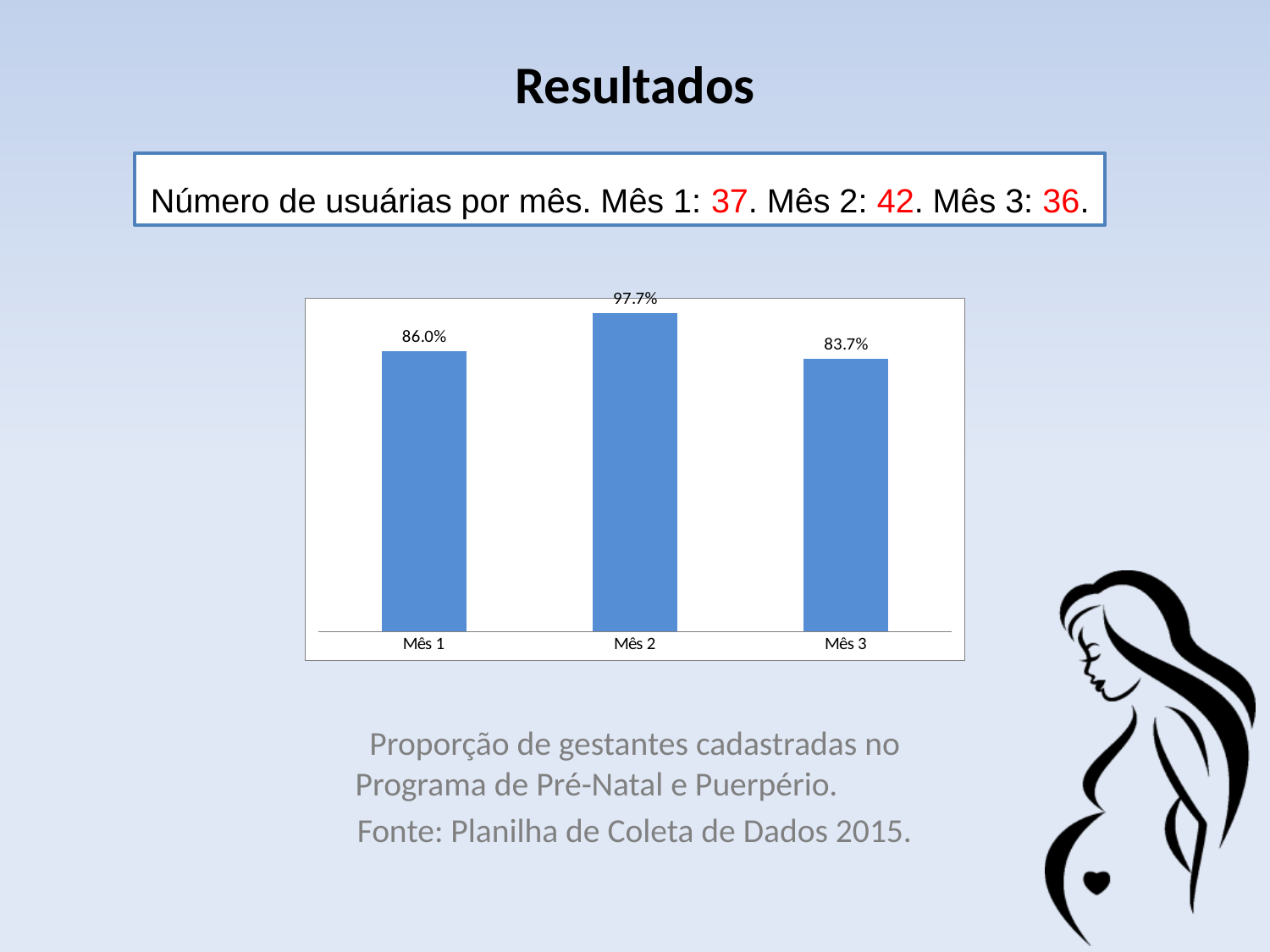
How many categories are shown on the x axis? 3 Which month has the lowest value? Mês 3 What is the difference between the values for Mês 2 and Mês 1? 11.7% What is the difference between the values for Mês 1 and Mês 3? 2.3% What is the value for Mês 2? 97.7% What is the value for Mês 1? 86.0% Does the value rise or fall from Mês 2 to Mês 3? Fall Which is larger, the value for Mês 2 or the value for Mês 3? Mês 2 What is the value for Mês 3? 83.7% What kind of chart is shown on the slide? Bar chart Which month has the highest value? Mês 2 What colour are the bars in the chart? Blue